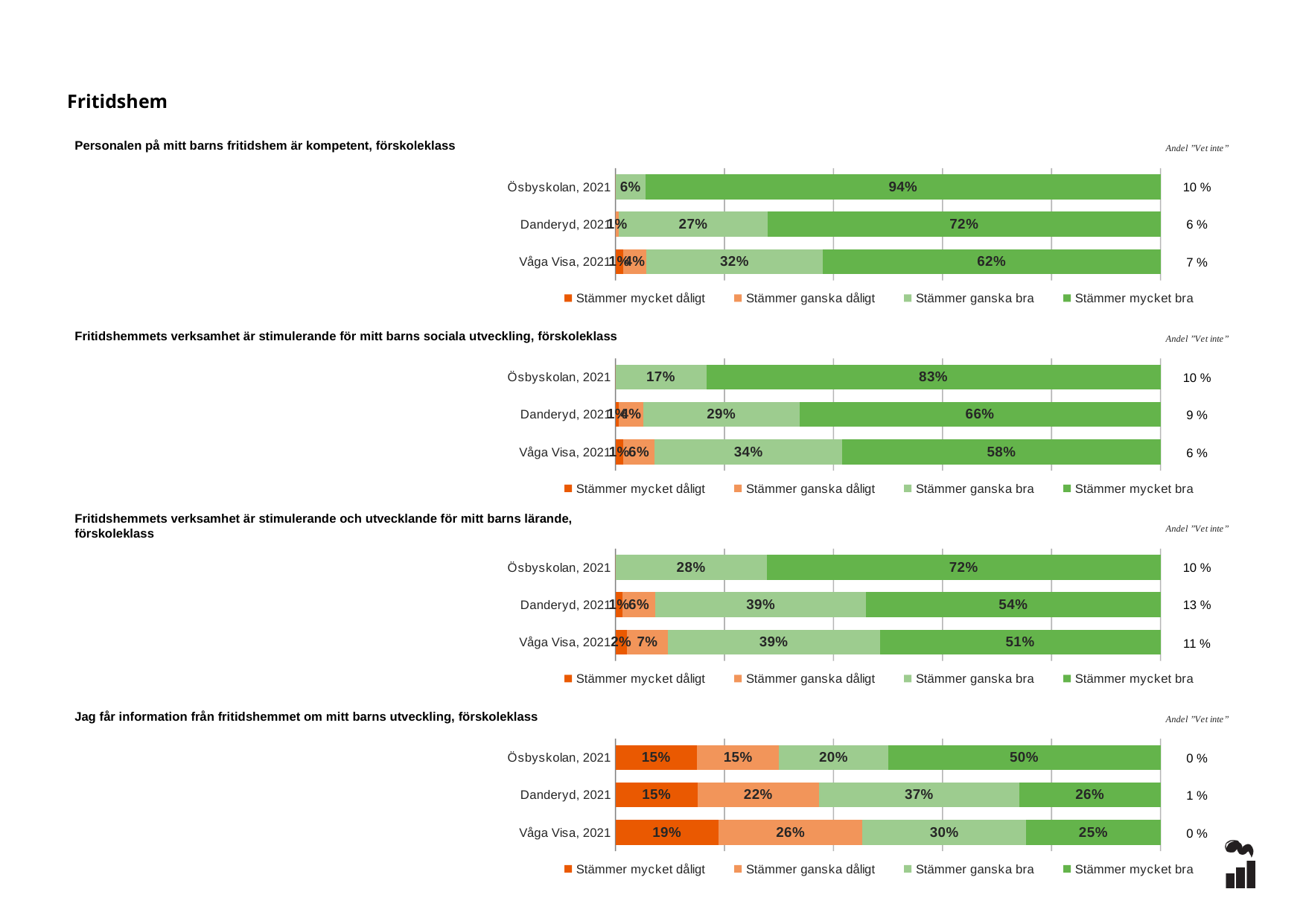
In the chart 'Personalen på mitt barns fritidshem är kompetent, förskoleklass', which row has the highest 'Stämmer mycket bra' value? Ösbyskolan, 2021 In the chart 'Fritidshemmets verksamhet är stimulerande för mitt barns sociala utveckling, förskoleklass', what is the difference between the 'Stämmer mycket bra' values for Ösbyskolan, 2021 and Danderyd, 2021? 17 percentage points In the chart 'Jag får information från fritidshemmet om mitt barns utveckling, förskoleklass', which is larger: the 'Stämmer mycket bra' value for Ösbyskolan, 2021 or for Danderyd, 2021? Ösbyskolan, 2021 In the chart 'Jag får information från fritidshemmet om mitt barns utveckling, förskoleklass', what is the 'Stämmer mycket dåligt' value for Våga Visa, 2021? 19% What kind of chart is the bottom chart on the slide? Stacked bar chart In the chart 'Personalen på mitt barns fritidshem är kompetent, förskoleklass', what is the 'Stämmer ganska bra' value for Danderyd, 2021? 27% In the chart 'Fritidshemmets verksamhet är stimulerande för mitt barns sociala utveckling, förskoleklass', what is the 'Stämmer mycket bra' value for Våga Visa, 2021? 58% In the chart 'Personalen på mitt barns fritidshem är kompetent, förskoleklass', what is the 'Stämmer mycket bra' value for Ösbyskolan, 2021? 94% In the chart 'Fritidshemmets verksamhet är stimulerande och utvecklande för mitt barns lärande, förskoleklass', which row has the lowest 'Stämmer mycket bra' value? Våga Visa, 2021 In the chart 'Fritidshemmets verksamhet är stimulerande och utvecklande för mitt barns lärande, förskoleklass', what is the 'Stämmer ganska bra' value for Ösbyskolan, 2021? 28% In the chart 'Jag får information från fritidshemmet om mitt barns utveckling, förskoleklass', what is the 'Andel Vet inte' value for Danderyd, 2021? 1 % How many series does the legend list in the chart 'Jag får information från fritidshemmet om mitt barns utveckling, förskoleklass'? 4